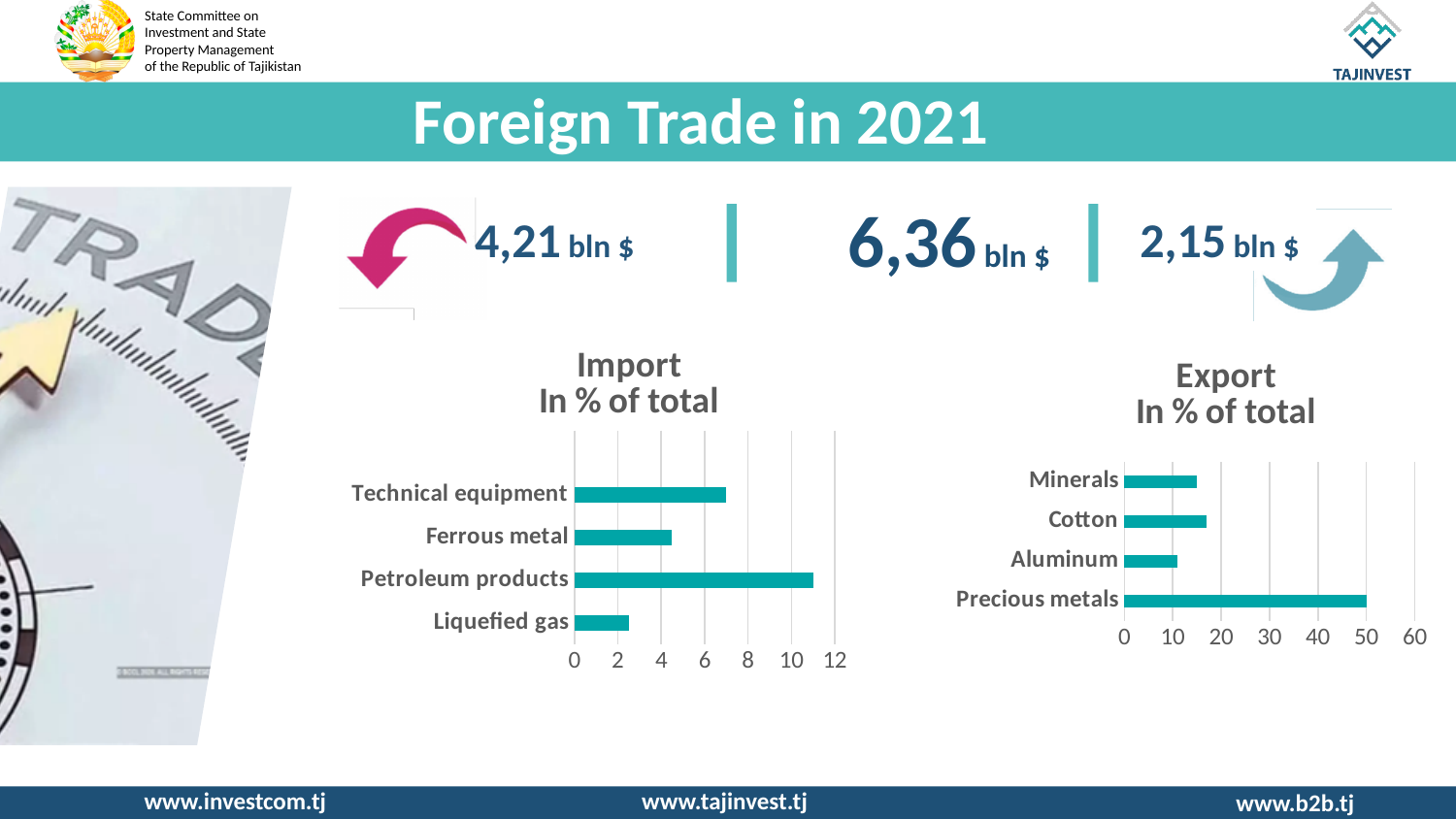
In the Import chart, is the value for Liquefied gas greater or less than 4? less What kind of chart is the Import chart? bar chart In the Import chart, which category has the lowest share? Liquefied gas In the Export chart, is the value for Aluminum greater or less than 20? less In the Export chart, is the value for Precious metals greater or less than 40? greater In the Export chart, which category has the lowest share? Aluminum How many categories are shown in the Import chart? 4 In the Import chart, which is larger, Technical equipment or Ferrous metal? Technical equipment What is the subtitle shown under the Export chart title? In % of total In the Import chart, which category has the highest share? Petroleum products In the Export chart, which category has the highest share? Precious metals